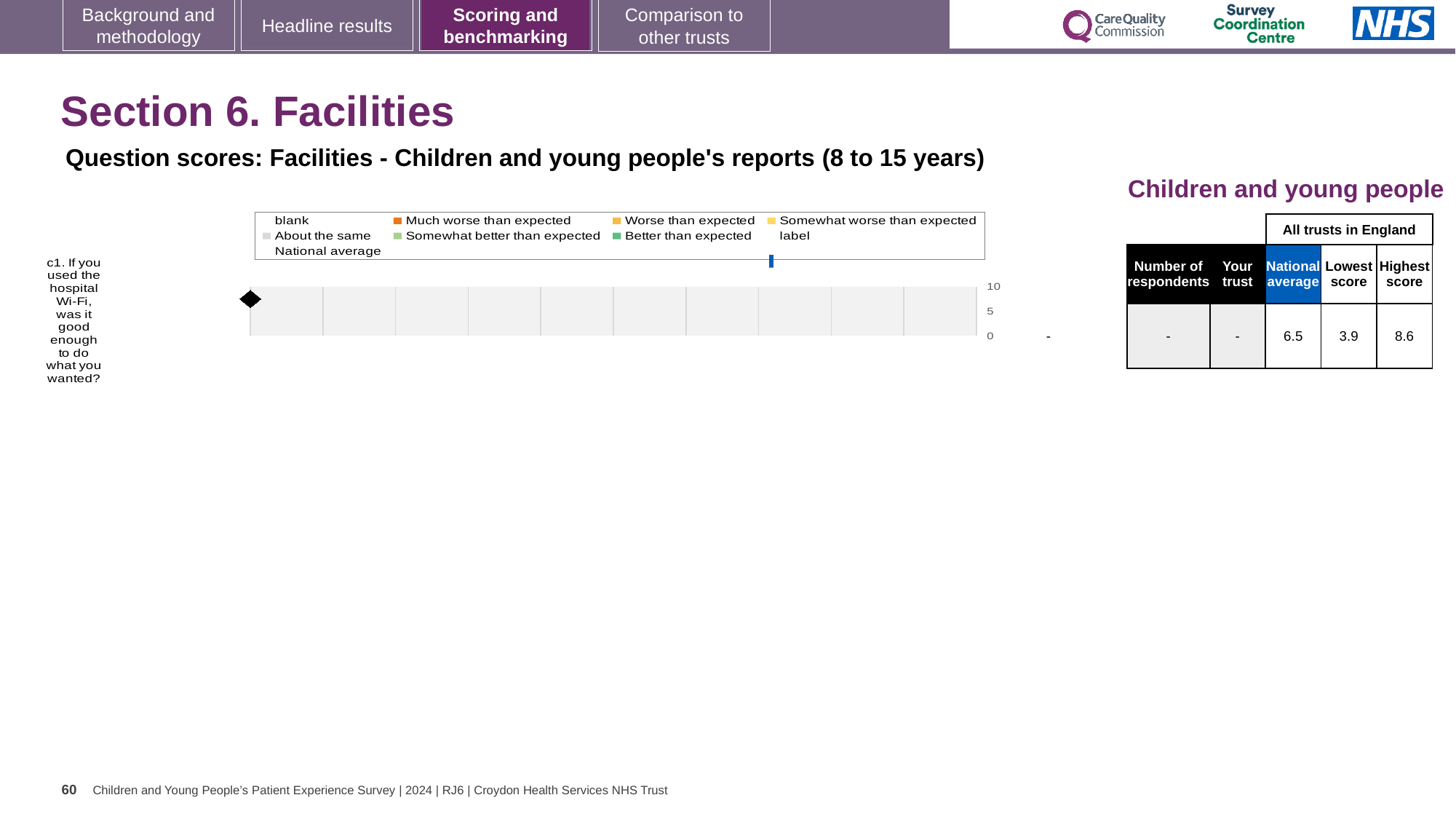
In the table, what is the national average score for question c1? 6.5 What is the difference between the highest score and the lowest score in the table for question c1? 4.7 In the table, what is shown as the score for your trust for question c1? - Is the national average score of 6.5 in the table greater or less than 5? greater Which is larger in the table for question c1, the national average or the lowest score? national average What is the highest value shown on the chart's vertical axis? 10 How many question categories are plotted on the chart? 1 In the table, what is the highest score across all trusts in England for question c1? 8.6 What kind of chart is shown on the slide? bar chart Which question is plotted on the chart? c1. If you used the hospital Wi-Fi, was it good enough to do what you wanted? In the table, what is the lowest score across all trusts in England for question c1? 3.9